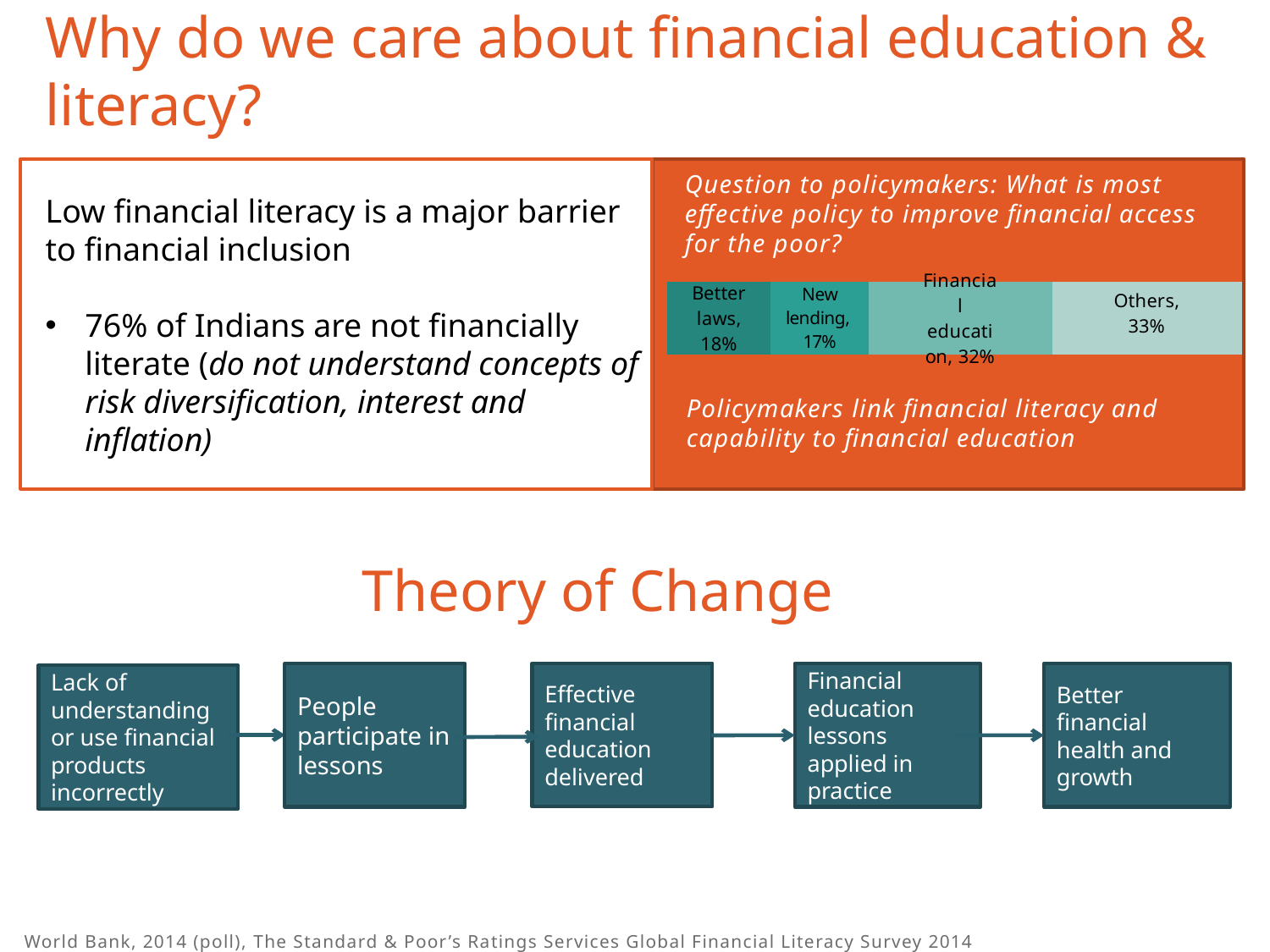
How many categories are shown in the policymaker poll chart? 4 What percentage is shown for 'New lending' in the policymaker poll chart? 17% What percentage is shown for 'Better laws' in the policymaker poll chart? 18% What share of policymakers chose financial education as the most effective policy to improve financial access for the poor? 32% What kind of chart is used to show the policymaker poll results? Stacked bar chart Which category has the largest share in the policymaker poll chart? Others What is the total of all segments in the policymaker poll bar? 100% What is the difference between the shares for financial education and better laws in the policymaker poll chart? 14 percentage points What percentage is shown for 'Others' in the policymaker poll chart? 33% What is the difference between the shares for 'Others' and 'New lending' in the policymaker poll chart? 16 percentage points Which is larger in the policymaker poll chart: the share for financial education or the share for new lending? Financial education Which category has the smallest share in the policymaker poll chart? New lending